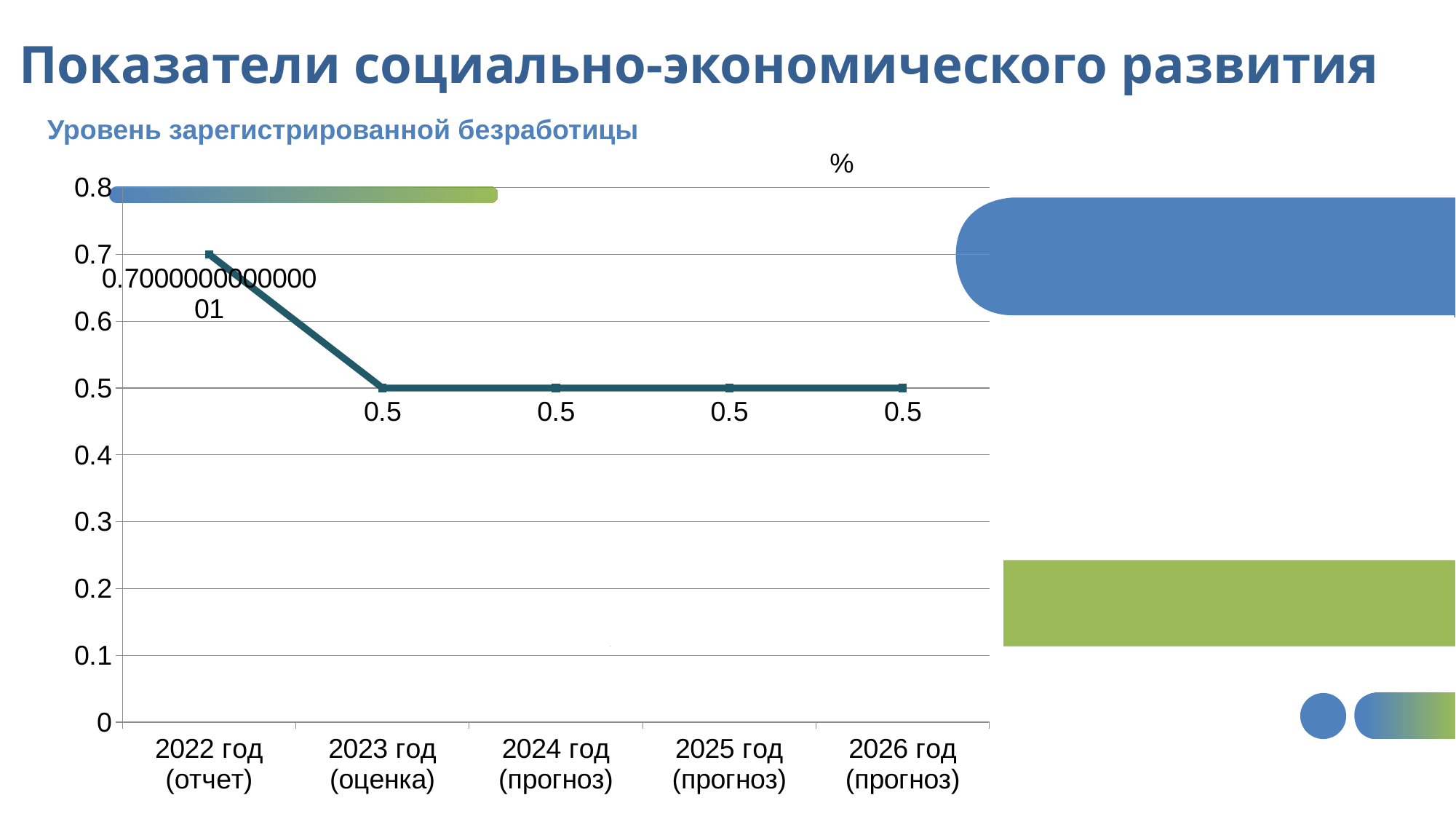
What kind of chart is shown on the slide? line chart What is the value plotted for 2026 год (прогноз)? 0.5 What is the value plotted for 2022 год (отчет)? 0.7 Is the value for 2022 год (отчет) greater or less than 0.6? greater What unit label is shown above the chart? % How many years are plotted on the x axis of the chart? 5 What is the difference between the values for 2022 год (отчет) and 2023 год (оценка)? 0.2 What is the registered unemployment rate for 2023 год (оценка)? 0.5 Which year has the highest value on the chart? 2022 год (отчет) Which is larger, the value for 2022 год (отчет) or the value for 2024 год (прогноз)? 2022 год (отчет) What is the value plotted for 2025 год (прогноз)? 0.5 Do the values rise or fall from 2022 год (отчет) to 2023 год (оценка)? fall